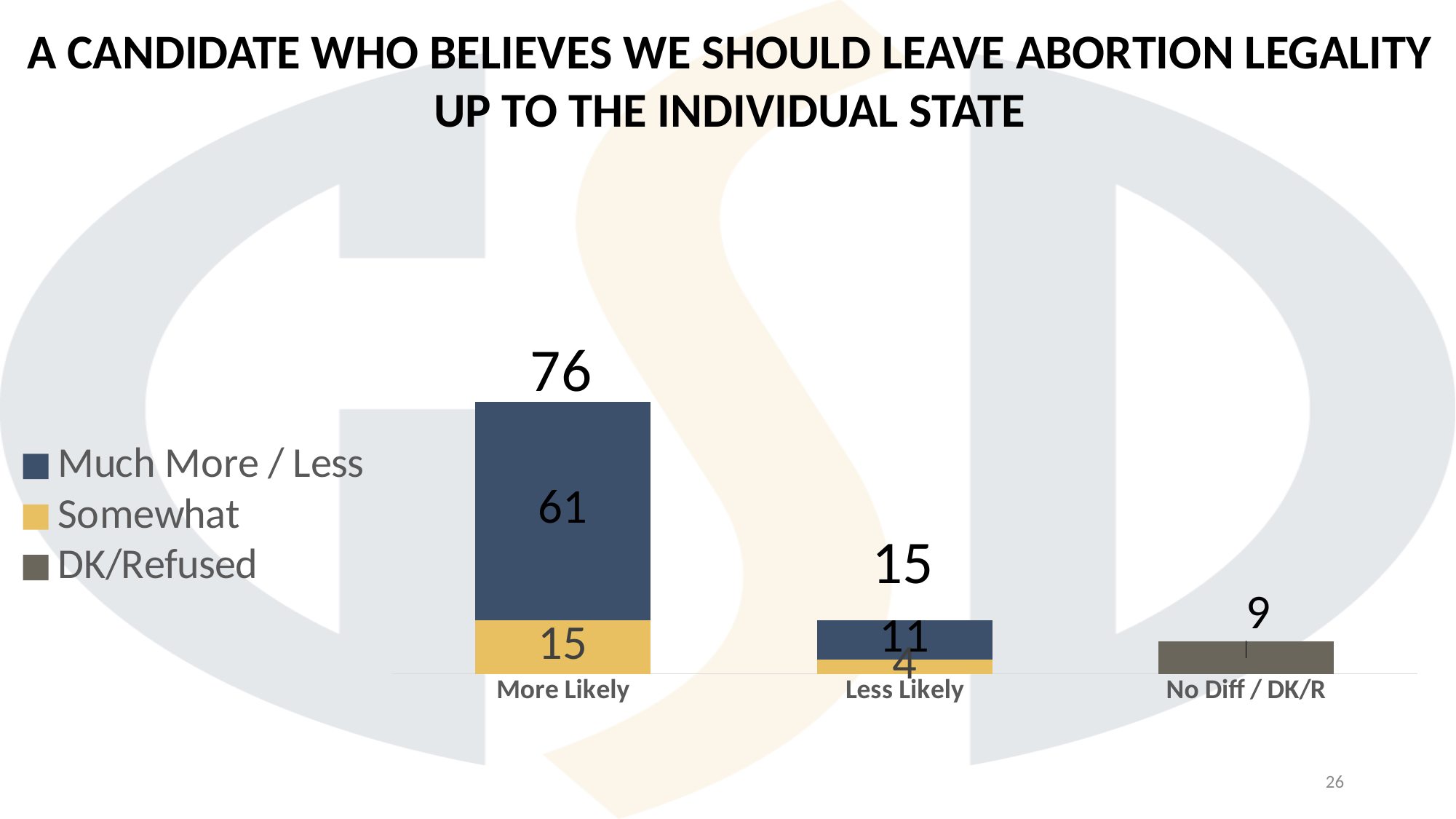
How many categories are shown on the x axis? 3 How many series does the legend list? 3 What is the Somewhat value for Less Likely? 4 What is the total of the stacked bar for More Likely? 76 What is the difference between the Much More / Less values for More Likely and Less Likely? 50 Which category has the highest total? More Likely Which is larger, the Somewhat value for More Likely or the Somewhat value for Less Likely? More Likely What kind of chart is shown? Stacked bar chart What is the total of the stacked bar for Less Likely? 15 What is the Much More / Less value for More Likely? 61 What is the DK/Refused value for No Diff / DK/R? 9 Which category has the lowest total? No Diff / DK/R